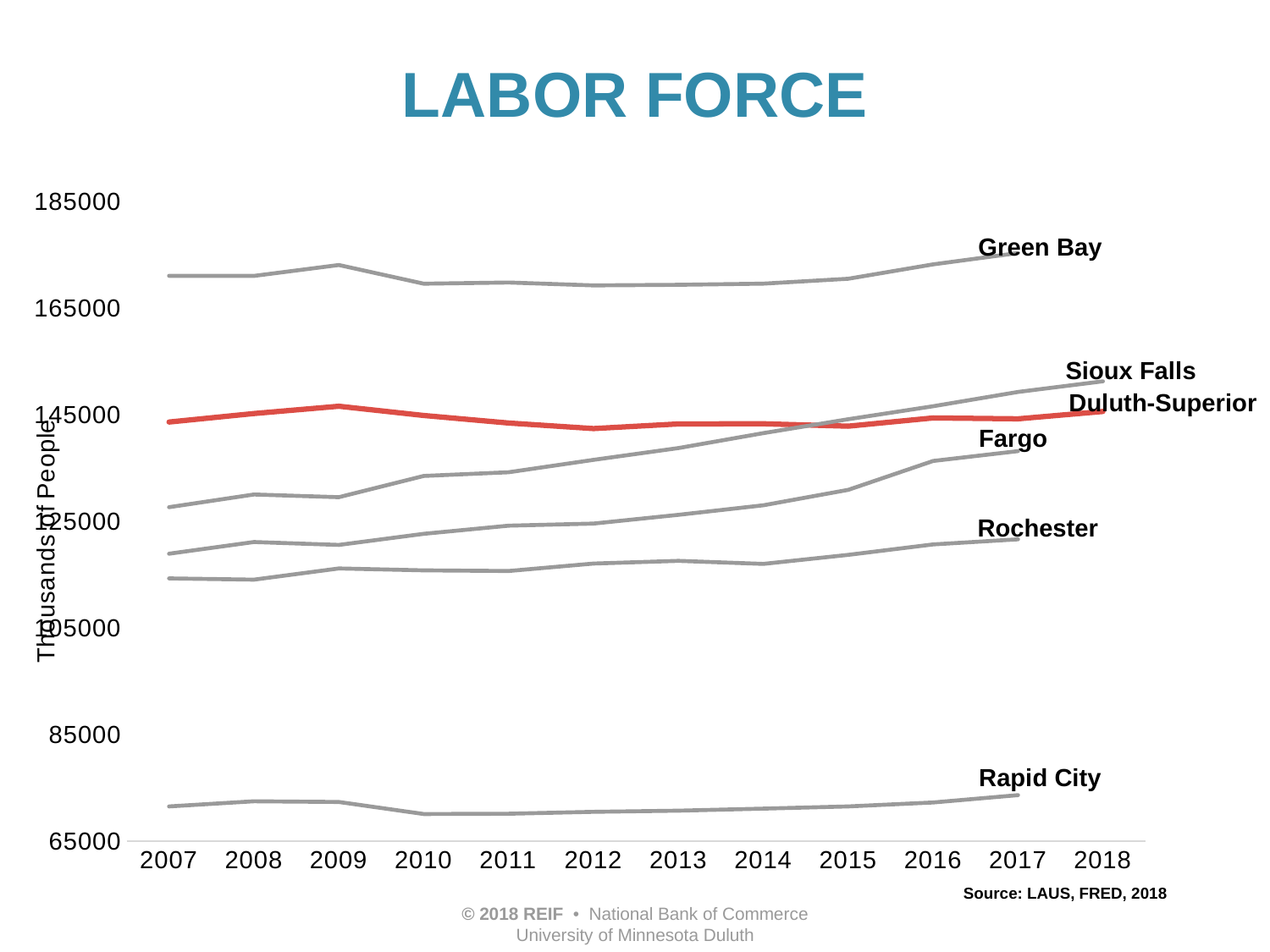
How many years are shown along the x axis? 12 Does the labor force for Sioux Falls rise or fall from 2007 to 2018? rise In 2007, which city had the larger labor force, Sioux Falls or Duluth-Superior? Duluth-Superior Is the labor force for Fargo in 2007 greater or less than 145000? less Which city has the lowest labor force throughout the period shown? Rapid City Is the labor force for Sioux Falls in 2018 greater or less than 145000? greater Is the labor force for Rapid City in 2010 greater or less than 85000? less What kind of chart is shown on the slide? Line chart Which city has the highest labor force throughout the period shown? Green Bay Which city's line is drawn in red on the chart? Duluth-Superior How many cities (series) are plotted on the chart? 6